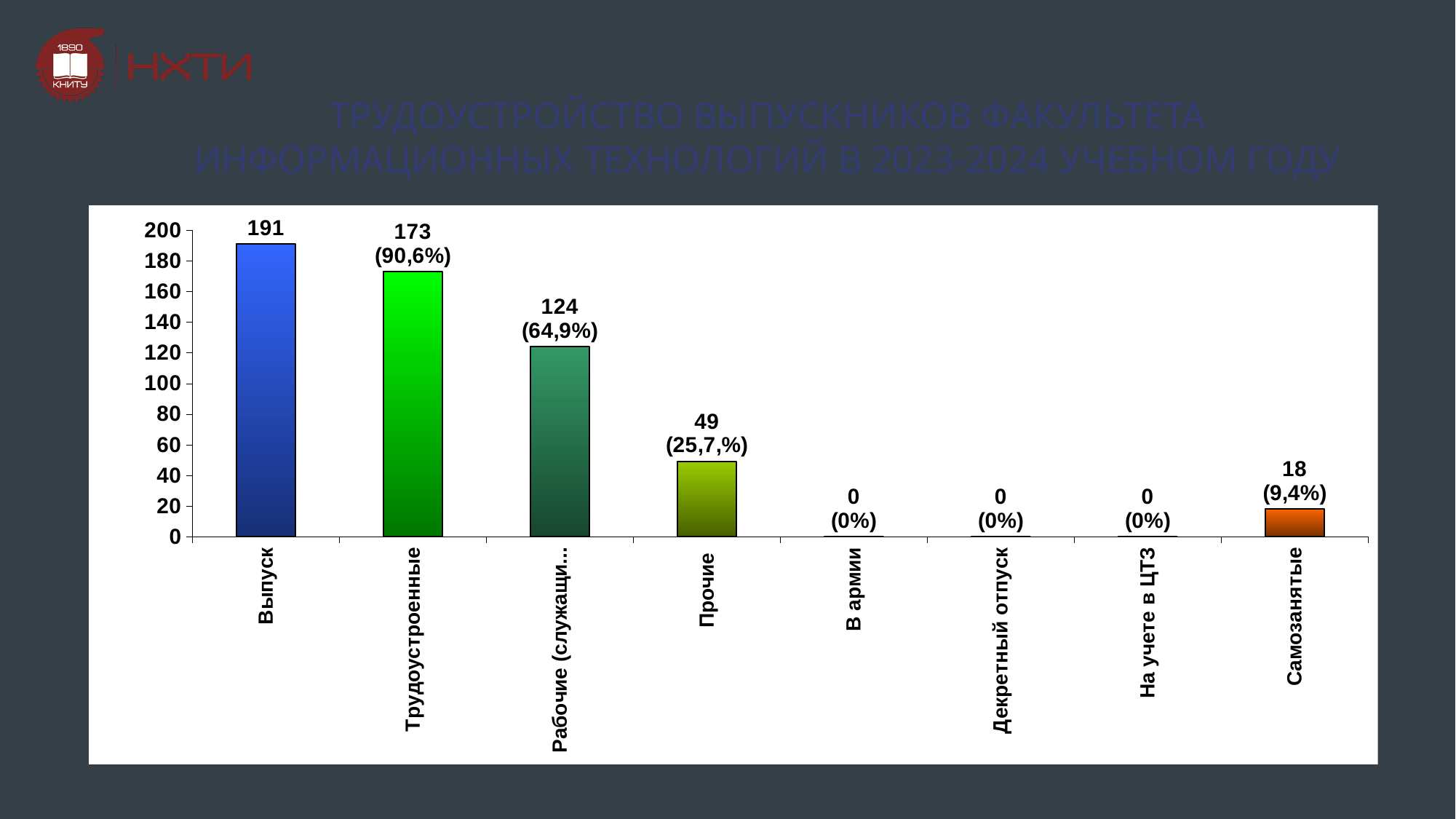
How many categories have a value of 0? 3 What kind of chart is shown on the slide? Bar chart What is the difference between the values for Выпуск and Трудоустроенные? 18 What percentage is shown for Самозанятые? 9,4% What is the value for Трудоустроенные? 173 What is the value for Выпуск? 191 How many categories are shown on the x axis? 8 What percentage is shown for Трудоустроенные? 90,6% Which is larger, the value for Прочие or the value for Самозанятые? Прочие What is the value for Самозанятые? 18 What is the value for Прочие? 49 Which category has the highest value? Выпуск